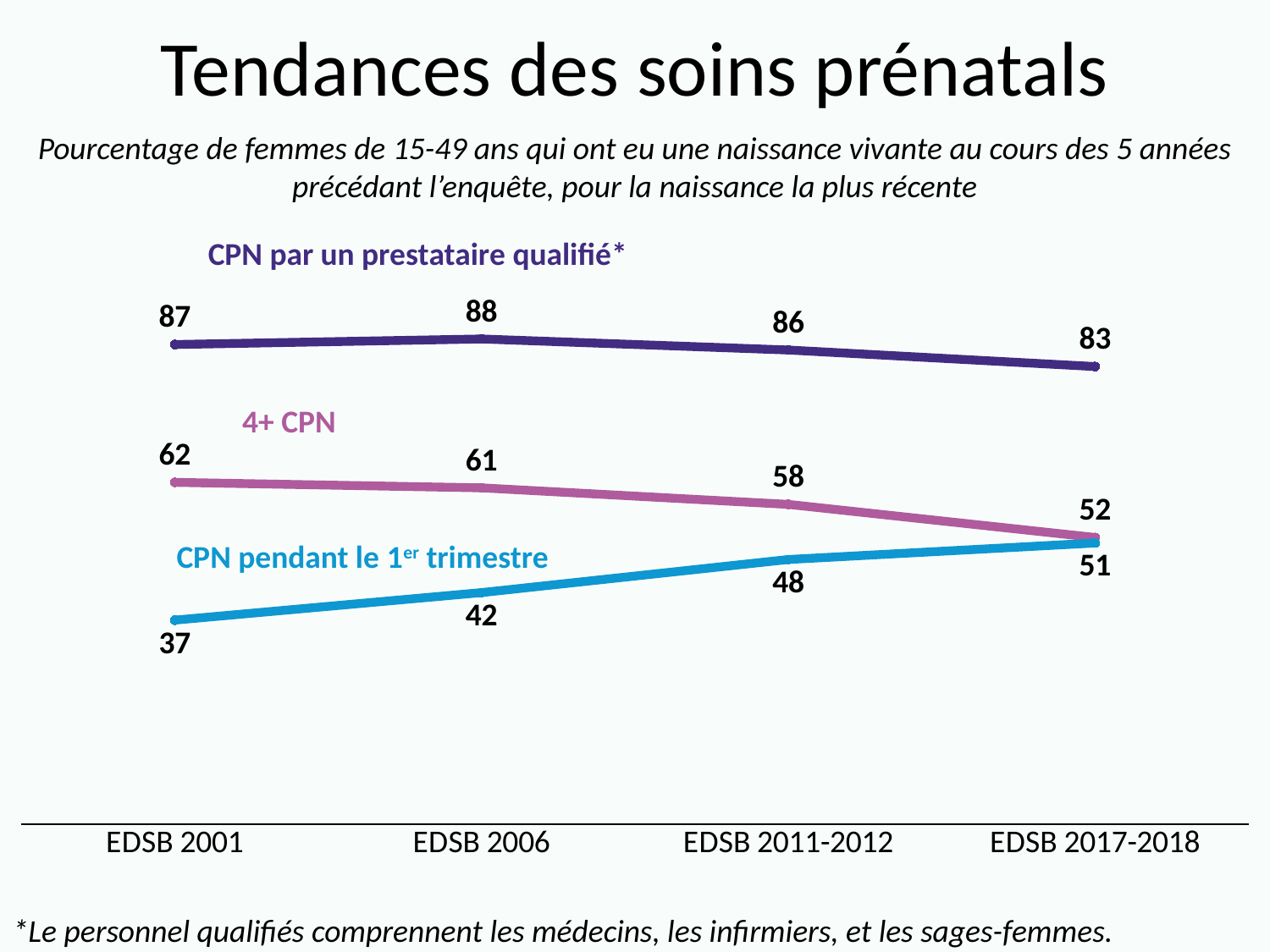
Which is larger at EDSB 2006: '4+ CPN' or 'CPN pendant le 1er trimestre'? 4+ CPN How many series are plotted on the chart? 3 What is the value for '4+ CPN' at EDSB 2011-2012? 58 How many survey points are plotted along the x axis? 4 Does 'CPN pendant le 1er trimestre' rise or fall from EDSB 2001 to EDSB 2017-2018? rise What is the value for 'CPN pendant le 1er trimestre' at EDSB 2001? 37 What type of chart is shown on the slide? line chart What is the value for 'CPN par un prestataire qualifié*' at EDSB 2017-2018? 83 What is the title of the slide? Tendances des soins prénatals In which survey is 'CPN par un prestataire qualifié*' highest? EDSB 2006 What is the difference between the '4+ CPN' values at EDSB 2001 and EDSB 2017-2018? 10 In which survey is 'CPN pendant le 1er trimestre' lowest? EDSB 2001